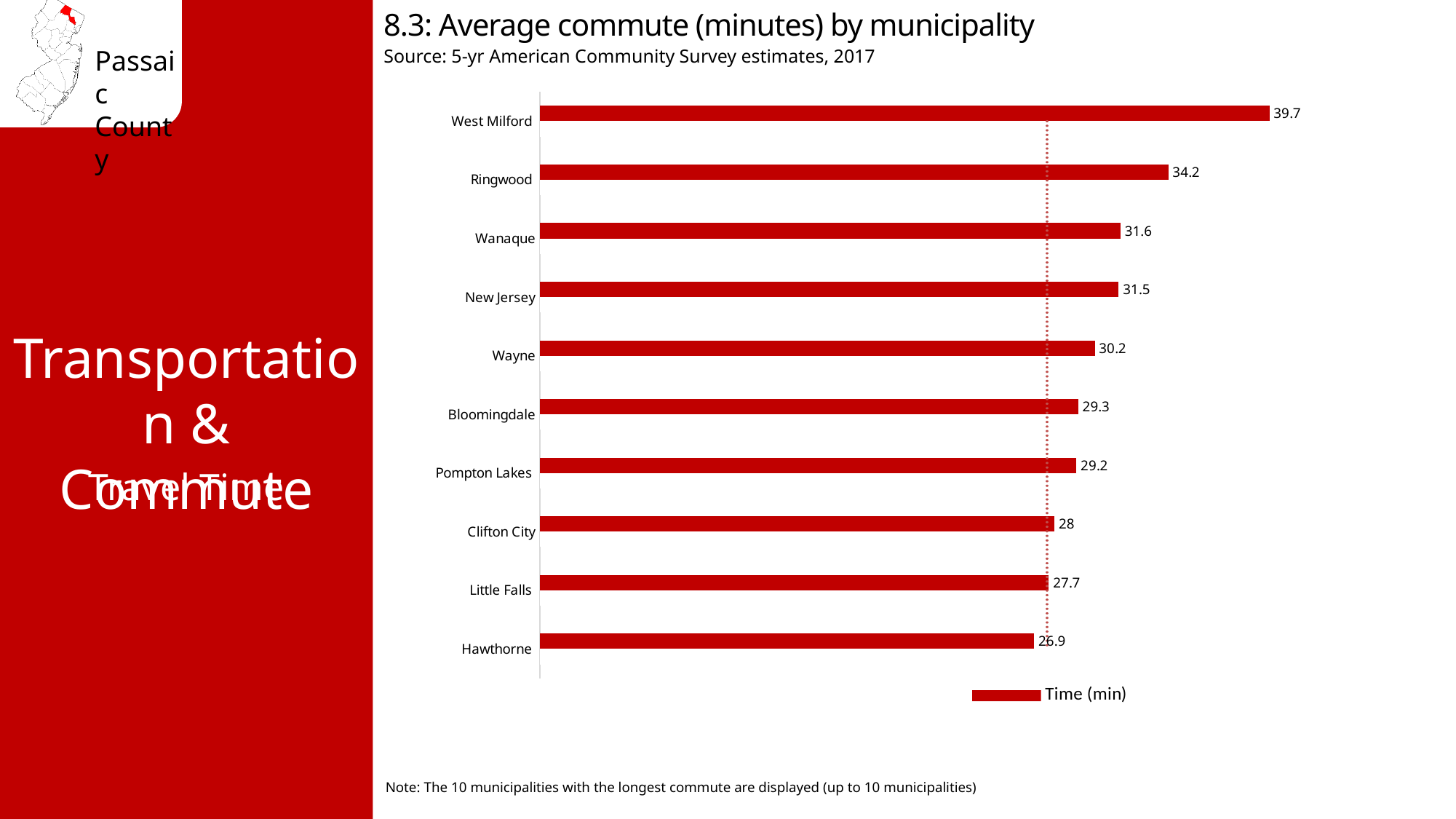
How many municipalities (bars) are shown in the chart? 10 Which has a longer average commute, Bloomingdale or Little Falls? Bloomingdale What is the average commute time for West Milford? 39.7 What is the difference in average commute time between West Milford and Ringwood? 5.5 What is the average commute time for Little Falls? 27.7 Which municipality shown has the shortest average commute? Hawthorne Which has a longer average commute, Ringwood or Wayne? Ringwood What type of chart is used on this slide? Bar chart Which municipality has the longest average commute? West Milford What is the legend entry for the series in the chart? Time (min) What is the average commute time for Wayne? 30.2 What is the difference in average commute time between Wanaque and Clifton City? 3.6